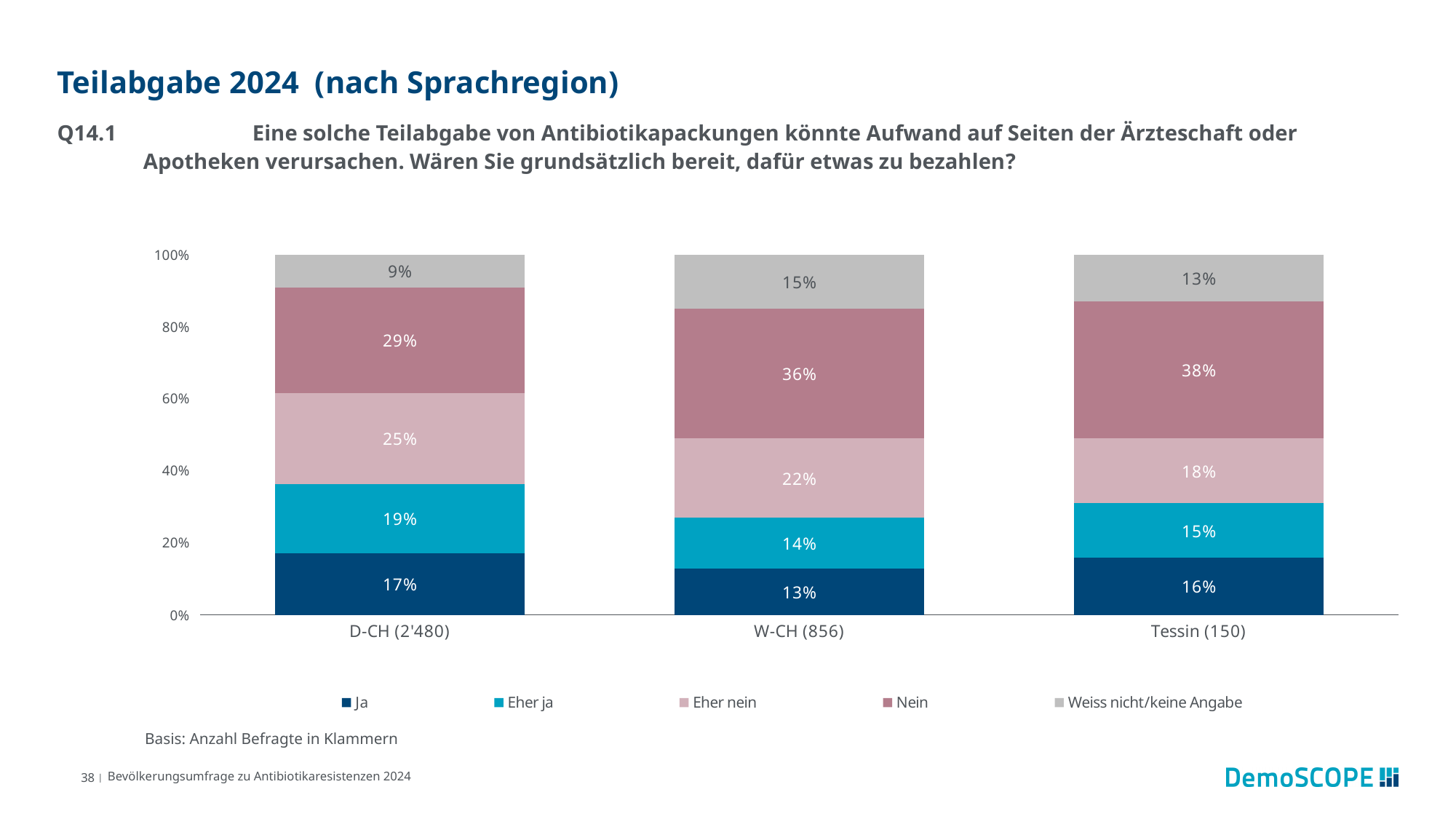
Is the 'Eher ja' value larger for D-CH (2'480) or for Tessin (150)? D-CH (2'480) Which language region has the lowest value for 'Ja'? W-CH (856) What is the value for 'Nein' in the Tessin (150) bar? 38% What is the value for 'Eher nein' in the W-CH (856) bar? 22% What is the difference between the 'Eher nein' values for D-CH (2'480) and Tessin (150)? 7 percentage points How many series does the legend list? 5 How many language regions are shown on the x axis? 3 What is the combined share of 'Ja' and 'Eher ja' in the W-CH (856) bar? 27% What is the value for 'Weiss nicht/keine Angabe' in the W-CH (856) bar? 15% Which language region has the highest value for 'Nein'? Tessin (150) What is the value for 'Ja' in the D-CH (2'480) bar? 17% What kind of chart is shown on the slide? Stacked bar chart